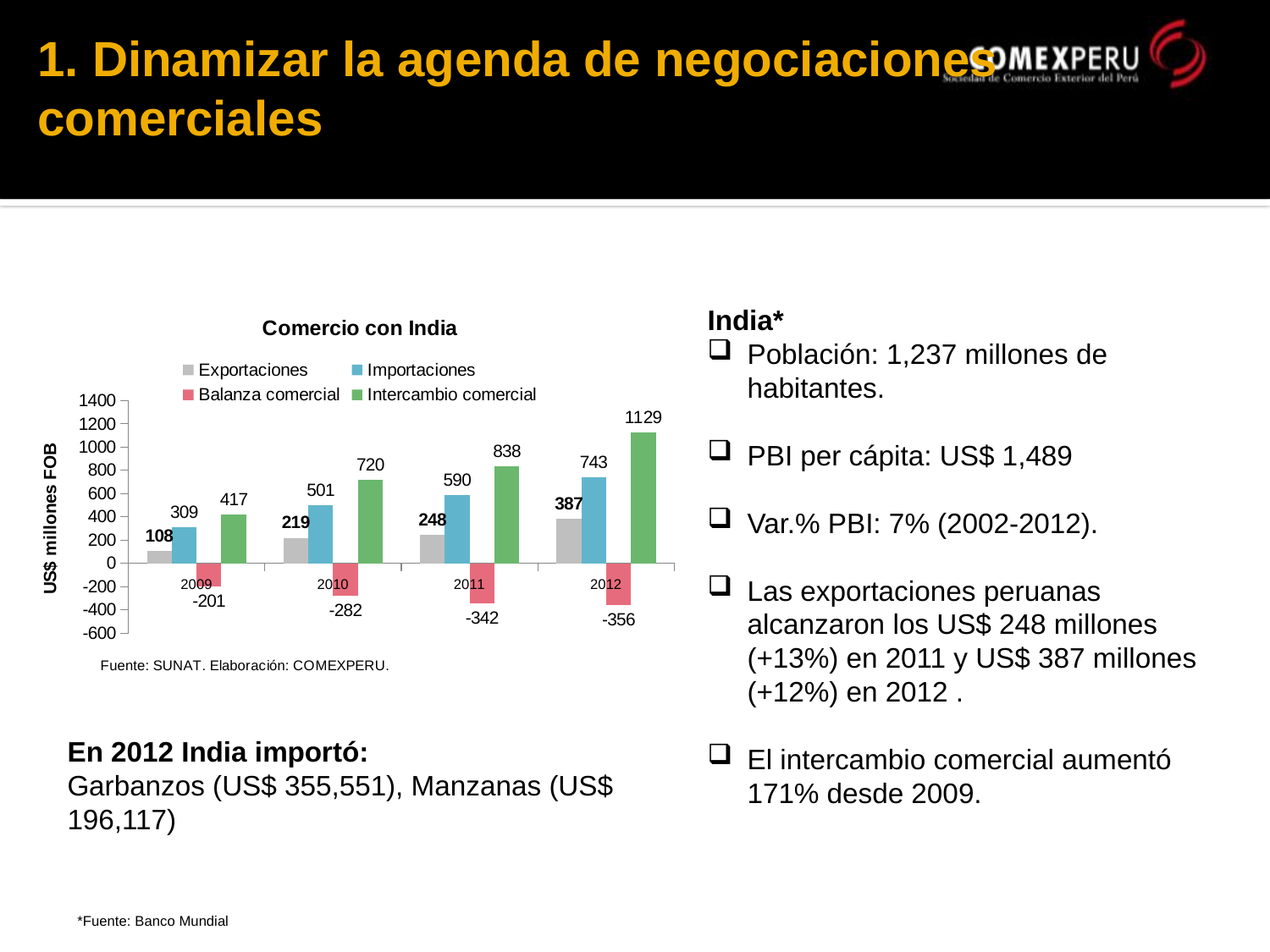
What is the difference between Importaciones in 2012 and Importaciones in 2011? 153 How many years are shown on the x axis of the "Comercio con India" chart? 4 In which year is Intercambio comercial highest? 2012 What is the value of Exportaciones in 2012? 387 Do the Intercambio comercial values rise or fall from 2009 to 2012? rise How many series does the legend of the "Comercio con India" chart list? 4 What is the value of Importaciones in 2010? 501 What is the value of Intercambio comercial in 2009? 417 What type of chart is shown under the title "Comercio con India"? bar chart Which is larger: Intercambio comercial in 2010 or Importaciones in 2012? Importaciones in 2012 What is the value of Balanza comercial in 2011? -342 In which year is Exportaciones lowest? 2009